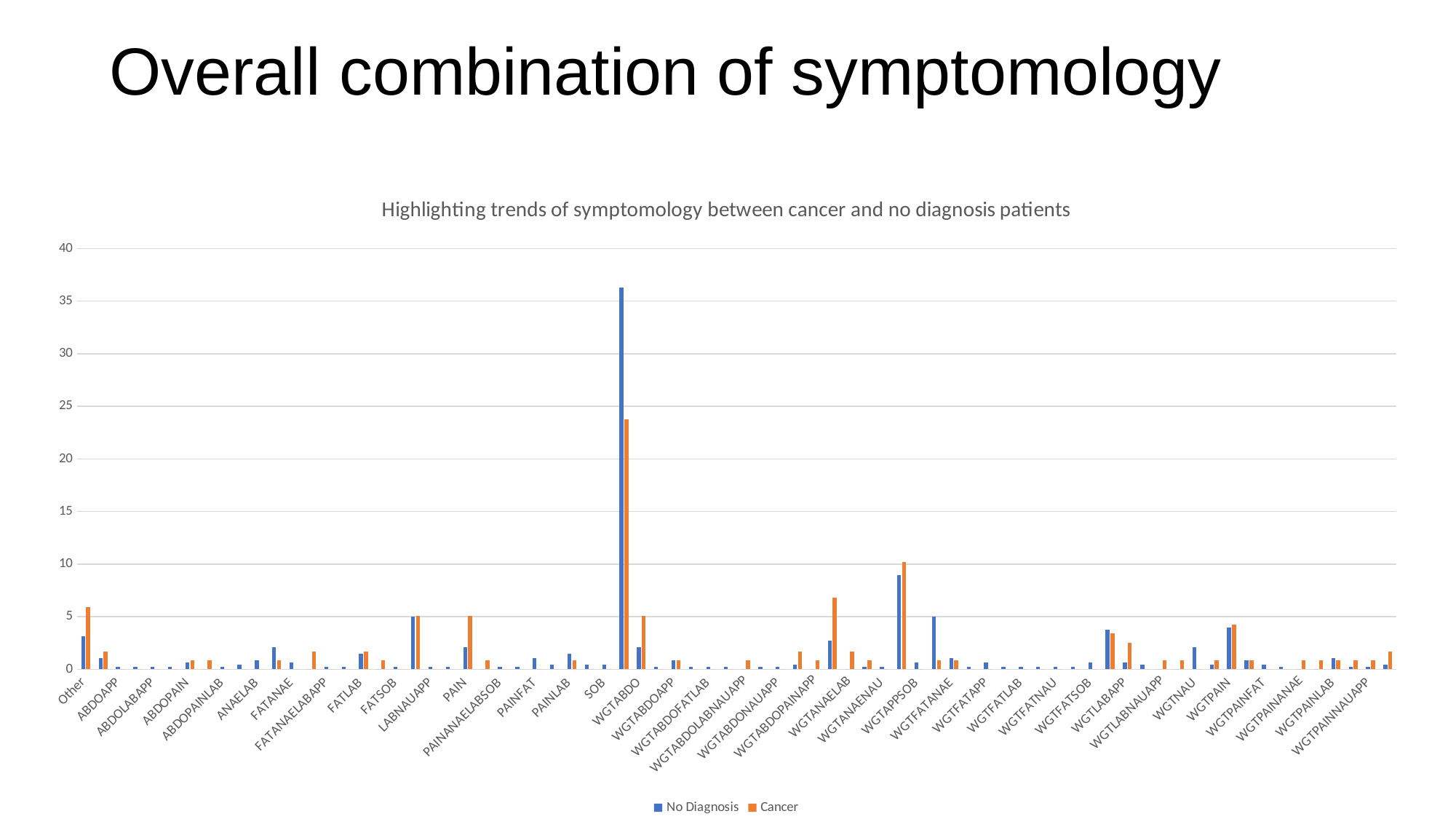
What kind of chart is shown on the slide? bar chart What is the title of the chart? Highlighting trends of symptomology between cancer and no diagnosis patients How many series does the legend list? 2 For PAIN, which series has the larger value, No Diagnosis or Cancer? Cancer For WGTFATANAE, which series has the larger value, No Diagnosis or Cancer? No Diagnosis What are the two series named in the legend? No Diagnosis and Cancer